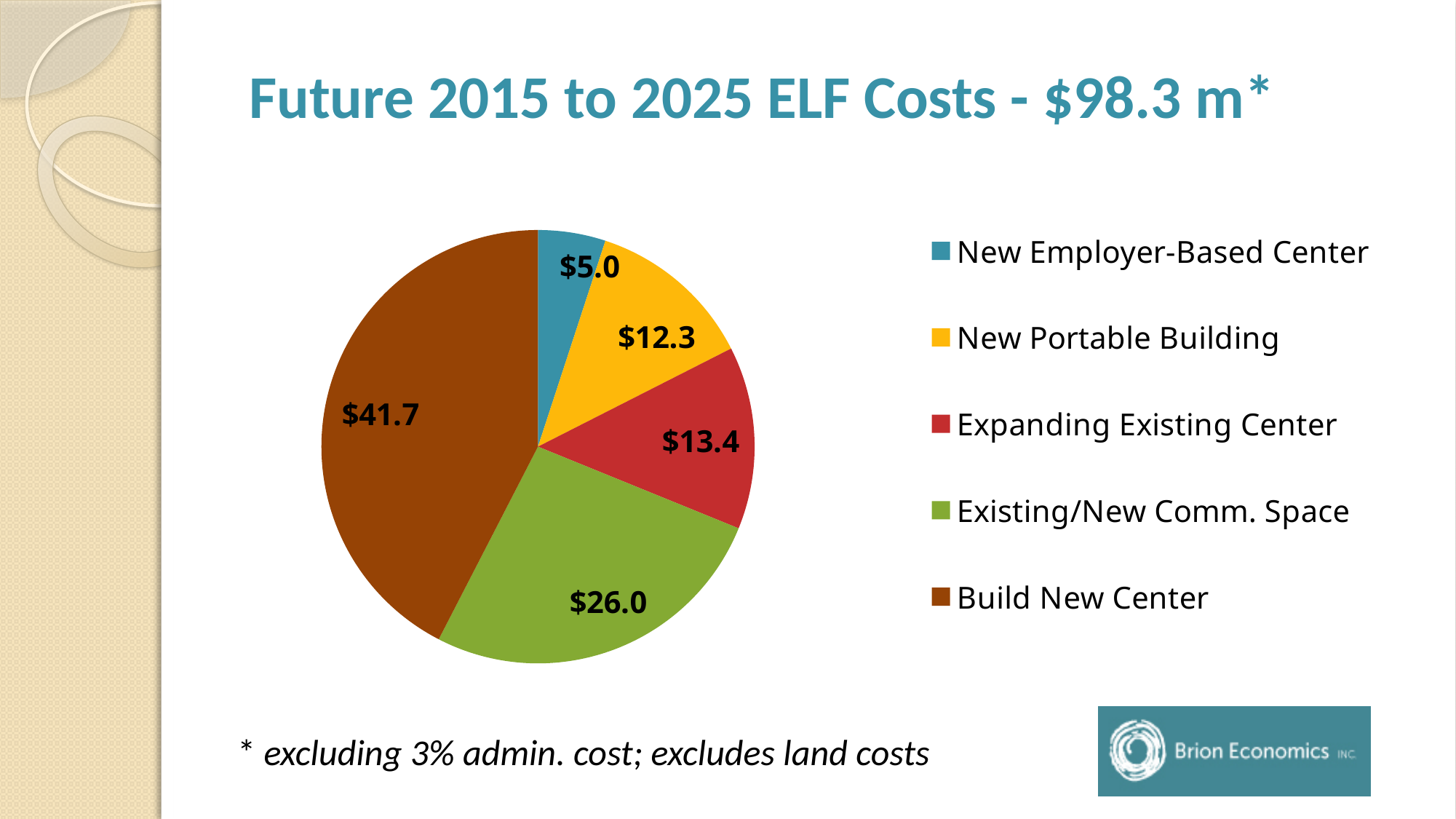
What is the difference between the values for Build New Center and Existing/New Comm. Space? $15.7 How many categories does the pie chart show? 5 What is the value for Build New Center? $41.7 Which category has the smallest slice of the pie? New Employer-Based Center What is the difference between the values for Expanding Existing Center and New Portable Building? $1.1 What is the value for New Portable Building? $12.3 Which is larger, the value for Existing/New Comm. Space or the value for Expanding Existing Center? Existing/New Comm. Space Which category has the largest slice of the pie? Build New Center What is the value for Expanding Existing Center? $13.4 What is the value for Existing/New Comm. Space? $26.0 What type of chart is shown on the slide? Pie chart What is the title of the chart slide? Future 2015 to 2025 ELF Costs - $98.3 m*